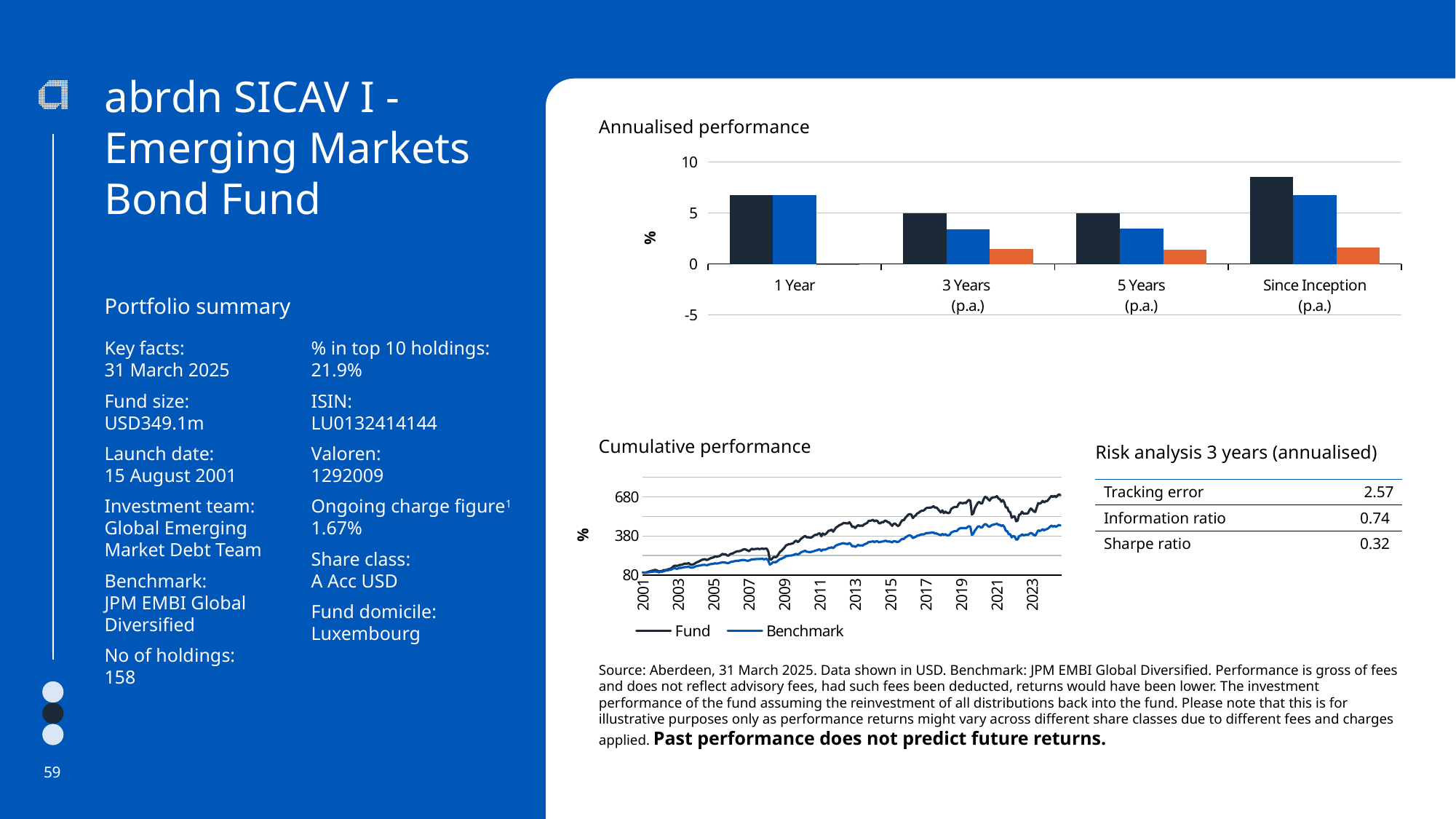
In the 'Annualised performance' chart, is the dark navy bar for Since Inception (p.a.) greater or less than 5? greater What is the y-axis label of the 'Annualised performance' chart? % In the 'Annualised performance' chart, is the blue bar for 1 Year greater or less than 5? greater How many categories are shown on the x axis of the 'Annualised performance' chart? 4 What kind of chart is the 'Annualised performance' chart? bar chart In the 'Cumulative performance' chart, which series is higher at the end of the period, Fund or Benchmark? Fund How many series does the legend of the 'Cumulative performance' chart list? 2 In the 'Annualised performance' chart, which category has the tallest dark navy bar? Since Inception (p.a.) In the 'Cumulative performance' chart, do the values generally rise or fall from 2001 to 2023? rise In the 'Annualised performance' chart, which is larger for 3 Years (p.a.): the dark navy bar or the orange bar? the dark navy bar In the 'Annualised performance' chart, is the orange bar for 3 Years (p.a.) greater or less than 5? less What kind of chart is the 'Cumulative performance' chart? line chart